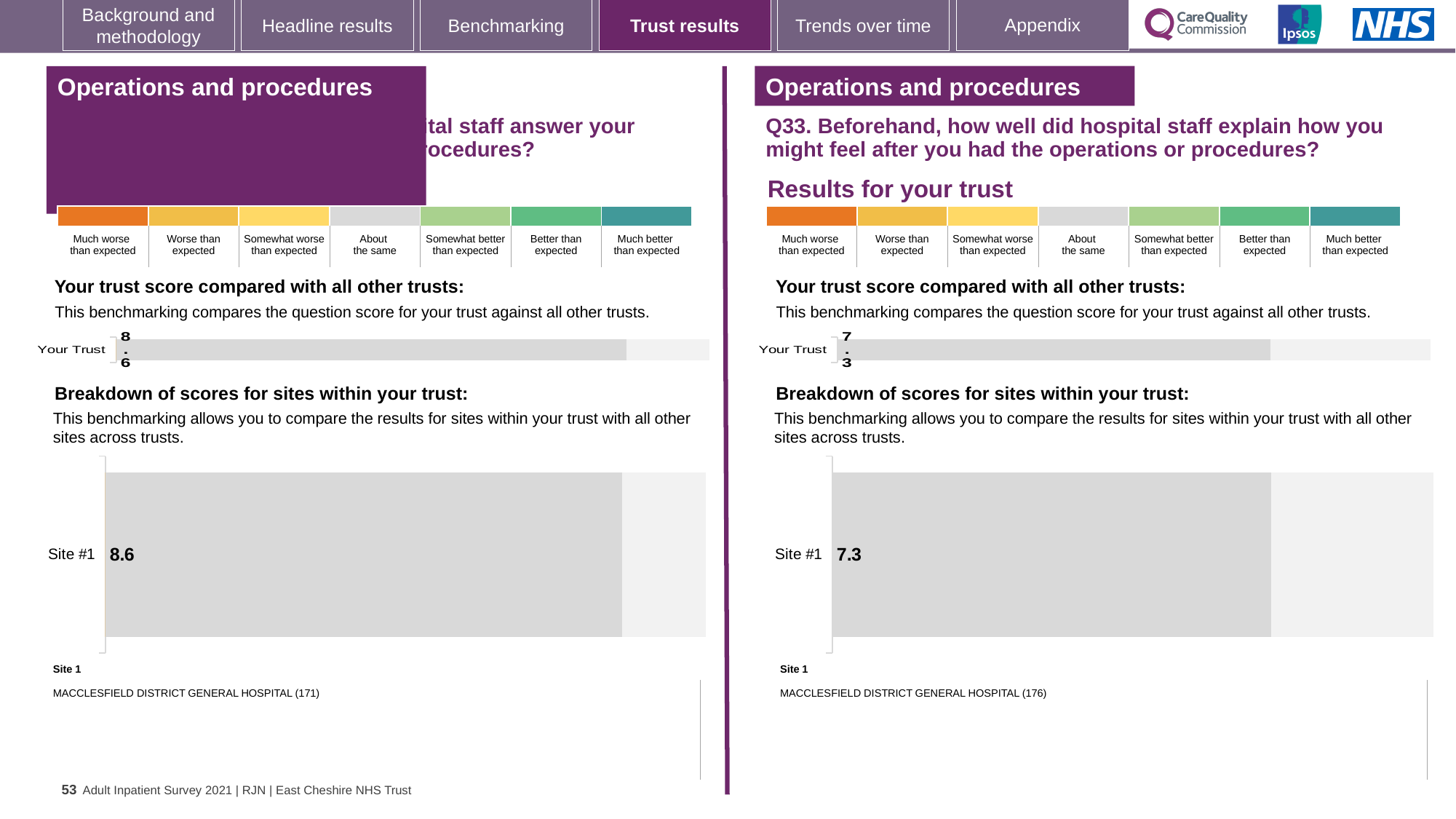
On the left panel, what is the name of Site 1 listed below the chart? MACCLESFIELD DISTRICT GENERAL HOSPITAL (171) What type of chart is used to show the Site #1 score on the right panel (Q33)? Bar chart On the right panel (Q33), what is the score shown for Your Trust in the 'Your trust score compared with all other trusts' chart? 7.3 On the right panel (Q33), what is the name of Site 1 listed below the chart? MACCLESFIELD DISTRICT GENERAL HOSPITAL (176) On the left panel, what is the score shown for Site #1 in the 'Breakdown of scores for sites within your trust' chart? 8.6 How many sites are shown in the 'Breakdown of scores for sites within your trust' chart on the left panel? 1 On the left panel, what is the score shown for Your Trust in the 'Your trust score compared with all other trusts' chart? 8.6 Which is larger: the Site #1 score on the left panel or the Site #1 score on the right panel (Q33)? Left panel (8.6) What is the difference between the Your Trust score on the left panel and the Your Trust score on the right panel (Q33)? 1.3 How many sites are shown in the 'Breakdown of scores for sites within your trust' chart on the right panel (Q33)? 1 What is the difference between the Site #1 score on the left panel and the Site #1 score on the right panel (Q33)? 1.3 On the right panel (Q33), what is the score shown for Site #1 in the 'Breakdown of scores for sites within your trust' chart? 7.3